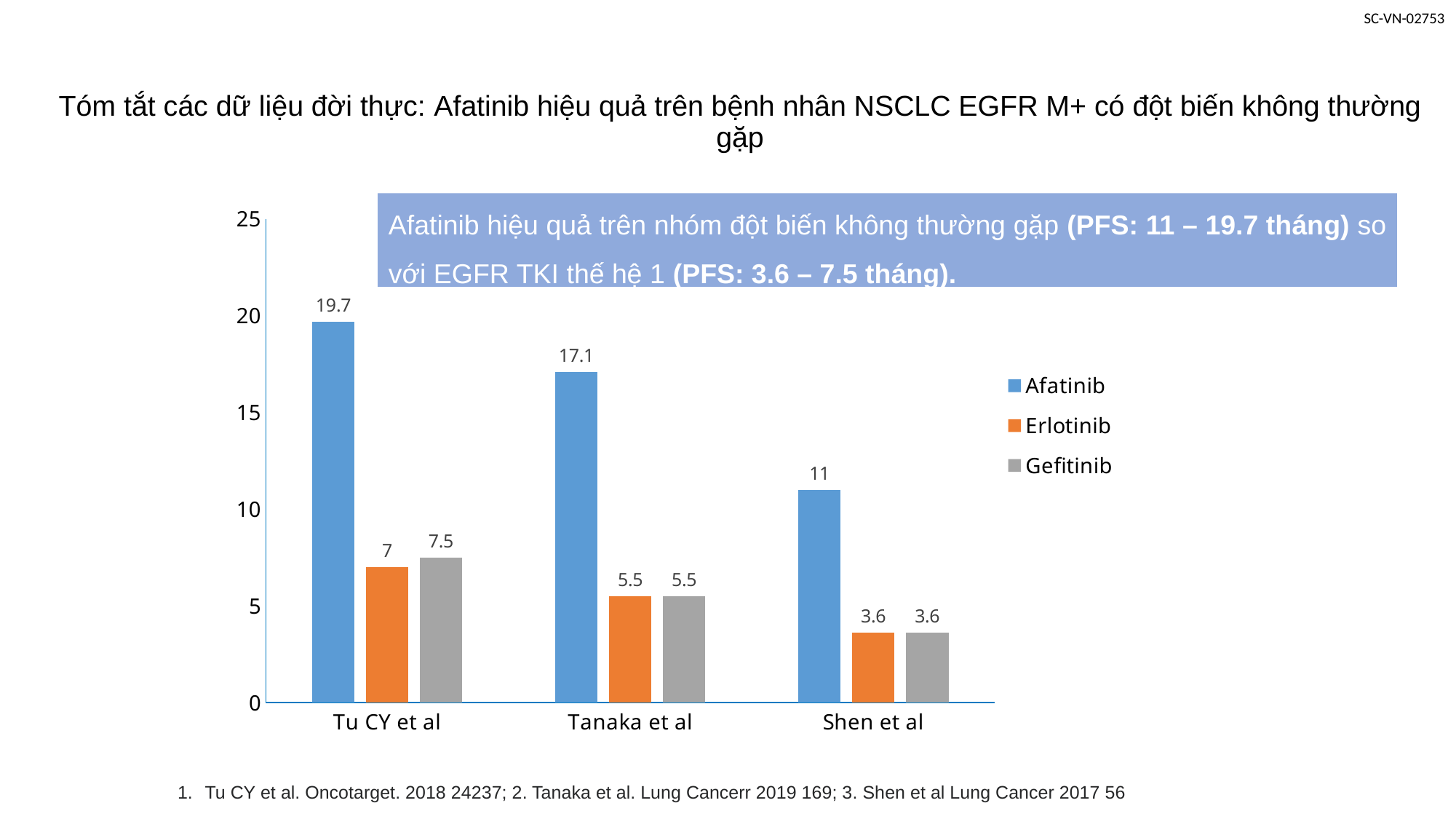
What is the Gefitinib value for Tu CY et al? 7.5 How many series does the legend list? 3 Do the Afatinib values rise or fall from Tu CY et al to Shen et al? fall Which is larger for Tu CY et al, the Erlotinib value or the Gefitinib value? Gefitinib What is the difference between the Afatinib and Erlotinib values for Tanaka et al? 11.6 Which study has the highest Afatinib value? Tu CY et al Which study has the lowest Afatinib value? Shen et al Is the Afatinib value for Shen et al greater or less than 10? greater What kind of chart is shown? bar chart What is the Afatinib value for Tu CY et al? 19.7 How many studies are shown on the x axis? 3 What is the Erlotinib value for Shen et al? 3.6